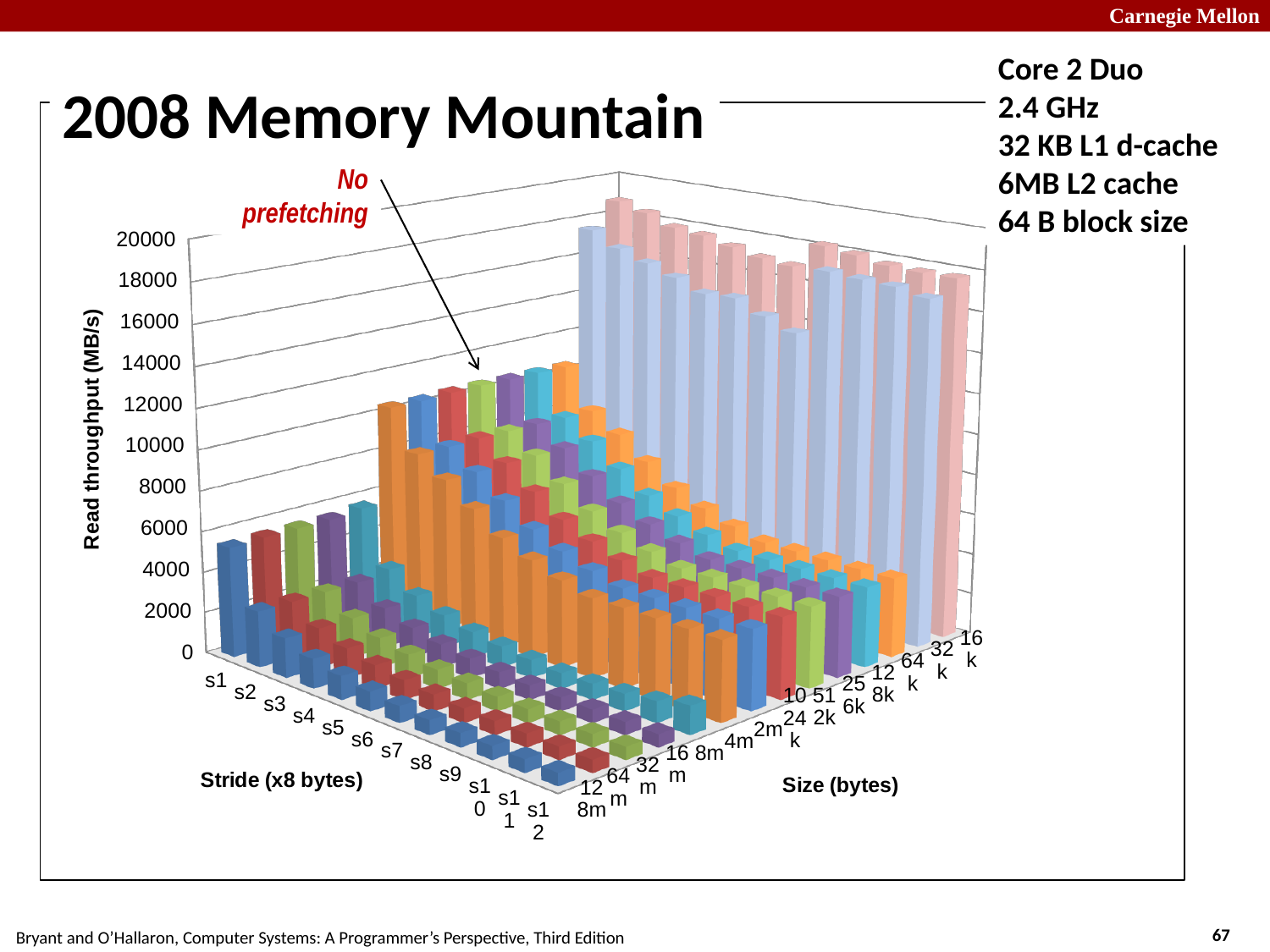
Which size region has the highest read throughput bars: the small sizes (16k–32k) or the large sizes (64m–128m)? small sizes (16k–32k) How many stride categories (s1 through s12) are shown on the stride axis? 12 Is the read throughput for stride s1 at size 128m greater or less than 8000? less Is the read throughput for stride s12 at size 128m greater or less than 4000? less Is the read throughput for stride s1 at size 32k greater or less than 14000? greater What is the label of the vertical axis? Read throughput (MB/s) What is the highest tick value shown on the read throughput axis? 20000 What kind of chart is shown on the slide? 3D bar chart For stride s1, does read throughput rise or fall as the size decreases from 128m toward 16k? rise Which stride has the highest read throughput at size 64m: s1 or s12? s1 What is the title of the chart? 2008 Memory Mountain